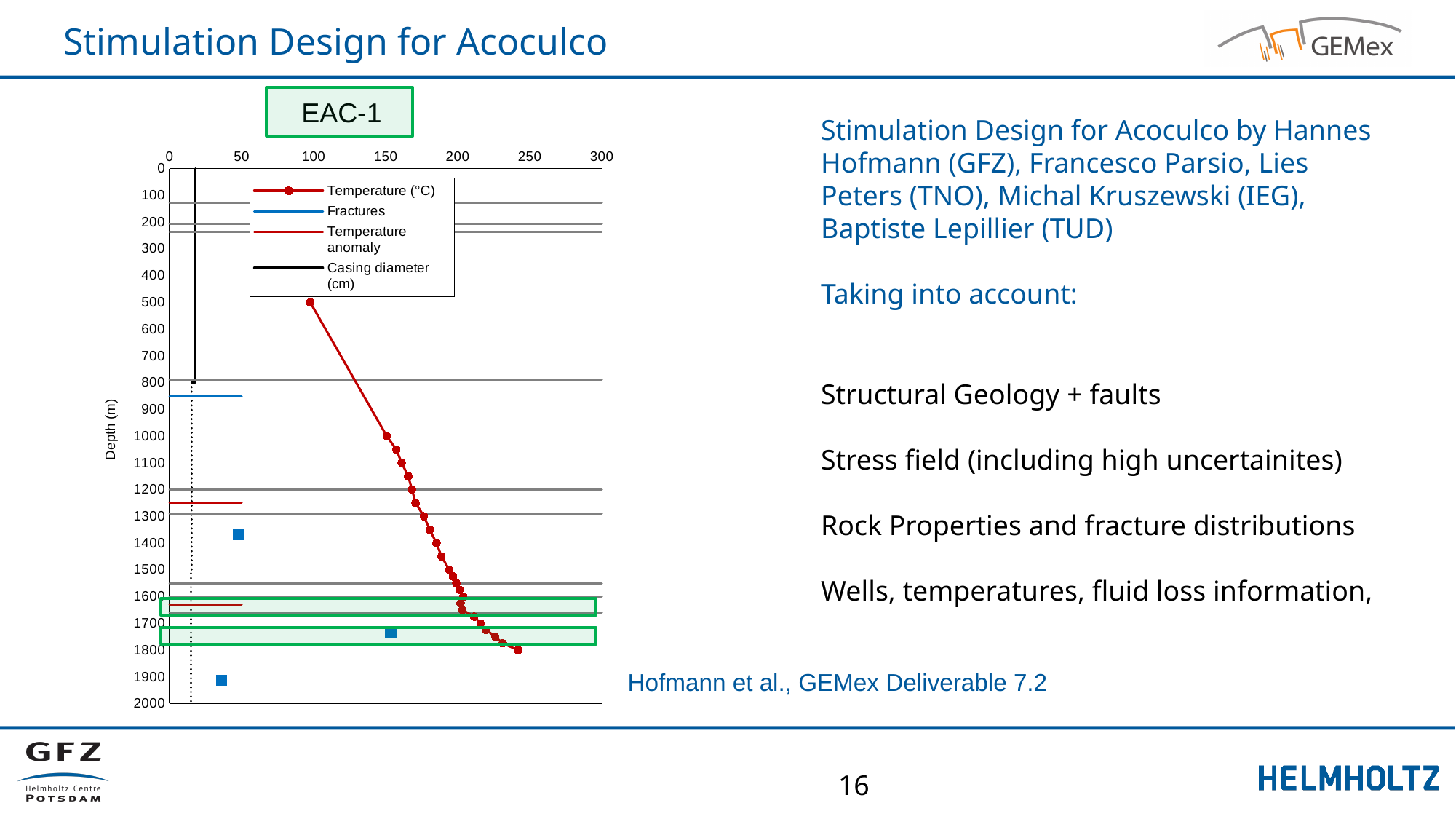
What is the maximum value shown on the horizontal axis of the chart? 300 How many series does the chart legend list? 4 Is the temperature at a depth of 1000 m greater or less than 100? greater At which depth does the Temperature (°C) series reach its highest value? 1800 Does the temperature increase or decrease as depth increases along the Temperature (°C) series? increase At which depth does the Temperature (°C) series have its lowest value? 500 What kind of chart is shown on the slide? line chart Is the temperature at a depth of 1800 m greater or less than 200? greater What is the label of the vertical axis of the chart? Depth (m) Which is larger, the temperature at 1800 m depth or the temperature at 1000 m depth? 1800 m What is the title shown above the chart? EAC-1 Is the temperature at a depth of 500 m greater or less than 150? less